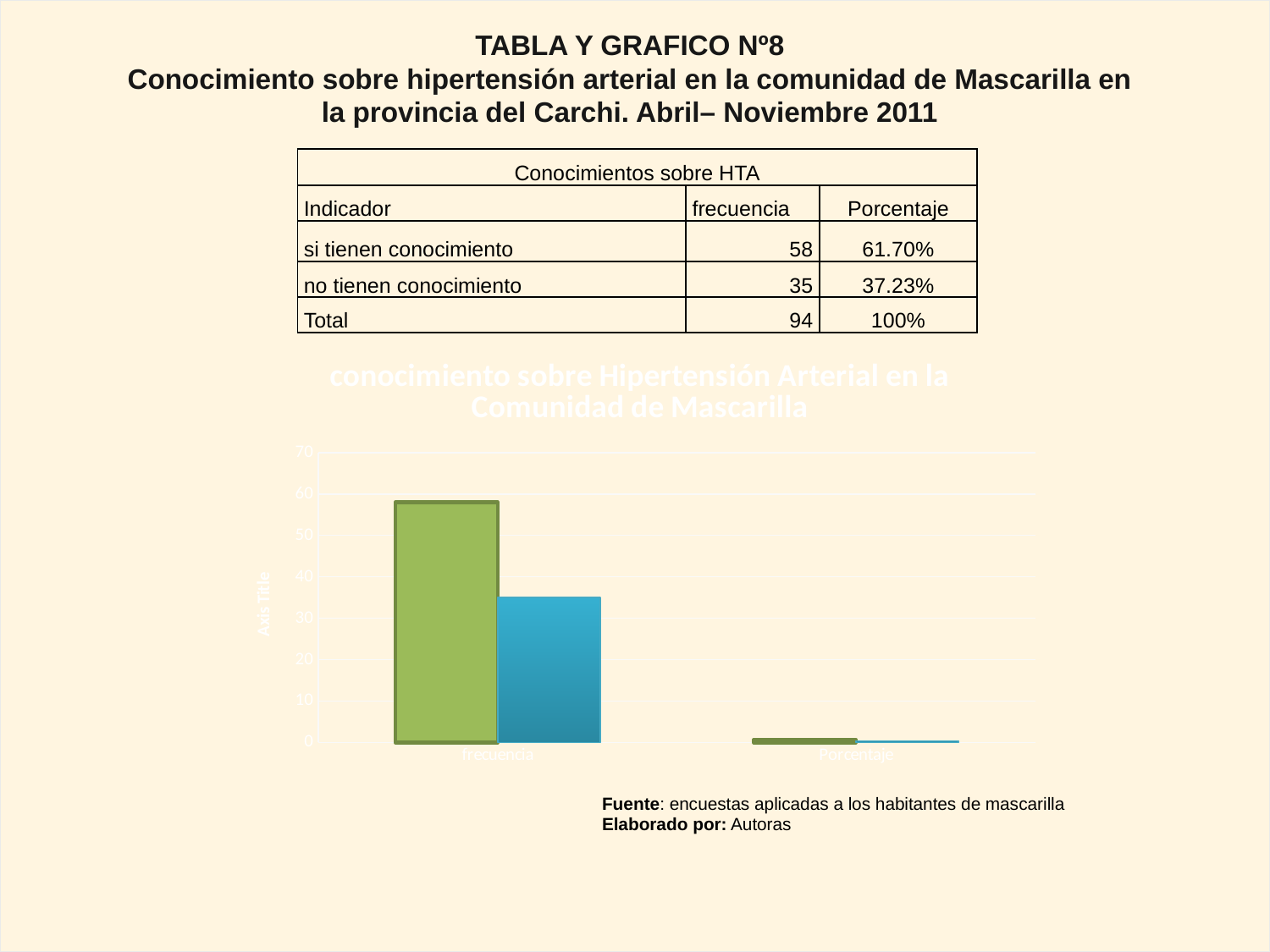
How many bars are plotted in the frecuencia group of the chart? 2 What text is shown as the vertical axis title of the chart? Axis Title What kind of chart is shown on the slide? bar chart Is the value of the blue bar in the frecuencia group greater or less than 30? greater Which category group on the x axis has the tallest bars? frecuencia Is the value of the blue bar in the frecuencia group greater or less than 40? less How many category groups are shown along the x axis of the chart? 2 In the frecuencia group, which bar is taller, the green one or the blue one? the green one Do the bar heights rise or fall moving from the frecuencia group to the Porcentaje group? fall What is the highest tick value shown on the vertical axis of the chart? 70 Is the value of the green bar in the frecuencia group greater or less than 50? greater